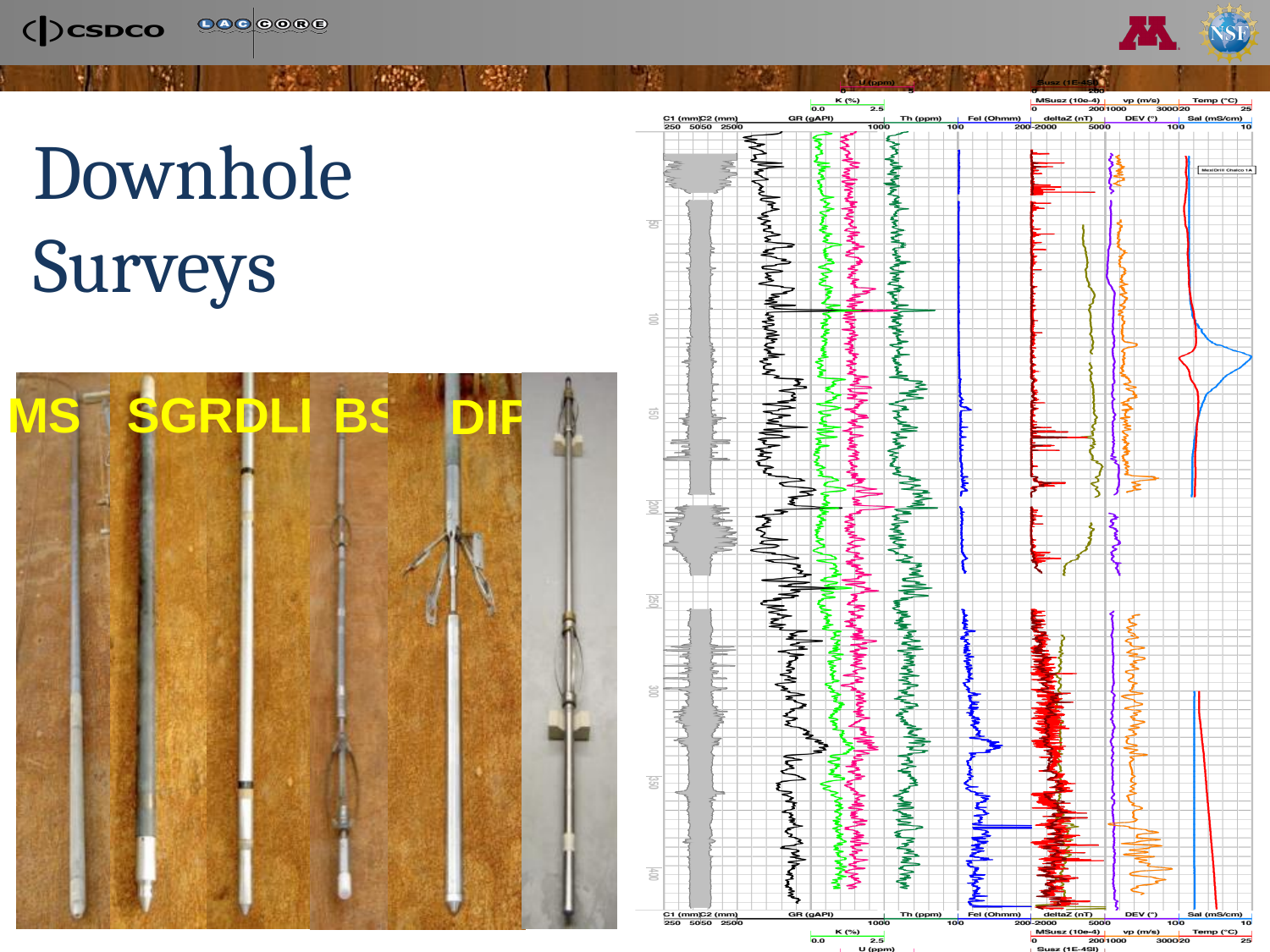
What kind of chart is the downhole survey plot on the right of the slide? line chart In the downhole survey plot, what unit is shown for the GR track? gAPI In the downhole survey plot, what range does the Temp (°C) axis span? 20 to 25 In the downhole survey plot, does the Temp (°C) curve in the lower part of the rightmost track rise or fall with increasing depth? rise